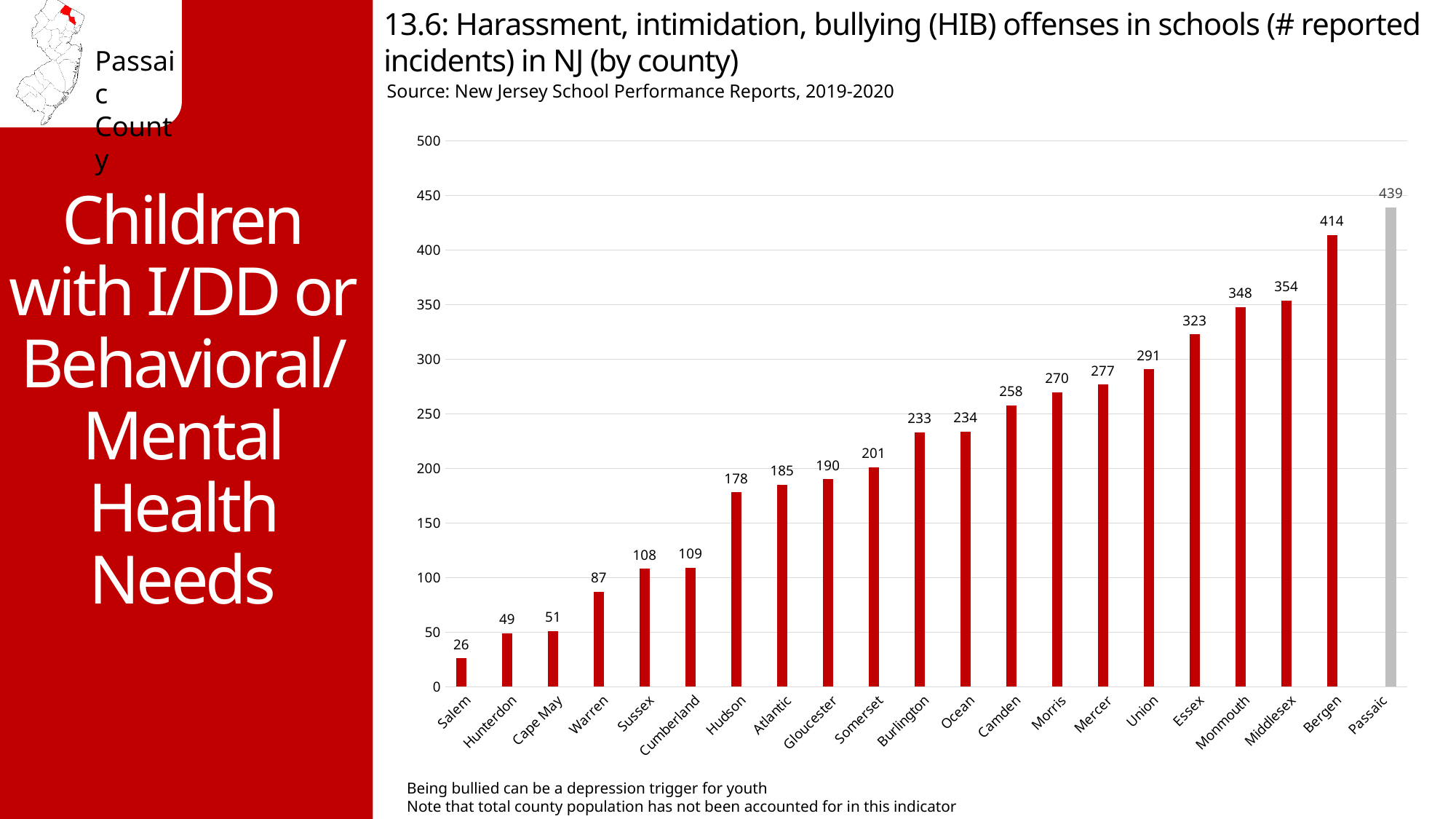
Which county has the highest number of reported HIB incidents? Passaic What is the number of reported HIB incidents for Hudson County? 178 Which county has the lowest number of reported HIB incidents? Salem How many counties are shown on the chart? 21 What is the difference in reported HIB incidents between Essex and Union? 32 What is the difference in reported HIB incidents between Passaic and Bergen? 25 What kind of chart is shown on the slide? Bar chart Which county's bar is coloured grey instead of red? Passaic How many HIB incidents were reported for Passaic County? 439 Which county has more reported HIB incidents, Monmouth or Middlesex? Middlesex Do the values rise or fall moving from left to right along the x axis? Rise Is the value for Camden greater or less than 250? greater